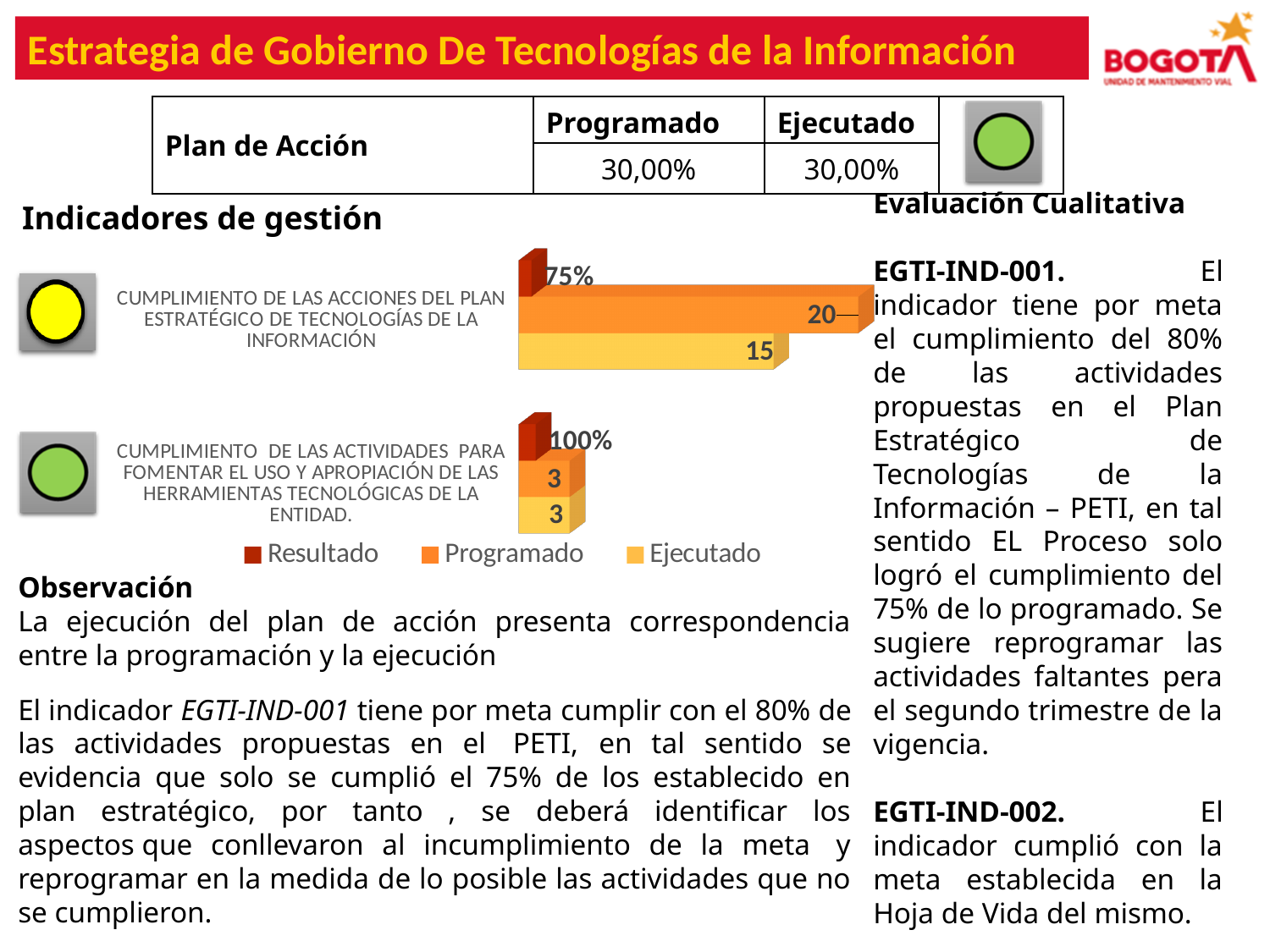
What is the Resultado value for 'Cumplimiento de las actividades para fomentar el uso y apropiación de las herramientas tecnológicas de la entidad'? 100% What is the Ejecutado value for 'Cumplimiento de las acciones del Plan Estratégico de Tecnologías de la Información'? 15 How many series does the chart legend list? 3 What is the Programado value for 'Cumplimiento de las actividades para fomentar el uso y apropiación de las herramientas tecnológicas de la entidad'? 3 What type of chart is shown under 'Indicadores de gestión'? Bar chart Which colour represents the Ejecutado series in the chart legend? Yellow For 'Cumplimiento de las acciones del Plan Estratégico de Tecnologías de la Información', which is larger, the Programado or the Ejecutado value? Programado What is the Programado value for 'Cumplimiento de las acciones del Plan Estratégico de Tecnologías de la Información'? 20 Which indicator has the lower Ejecutado value? Cumplimiento de las actividades para fomentar el uso y apropiación de las herramientas tecnológicas de la entidad What is the Resultado value for 'Cumplimiento de las acciones del Plan Estratégico de Tecnologías de la Información'? 75% What is the difference between the Programado and Ejecutado values for 'Cumplimiento de las acciones del Plan Estratégico de Tecnologías de la Información'? 5 Which indicator has the higher Programado value? Cumplimiento de las acciones del Plan Estratégico de Tecnologías de la Información